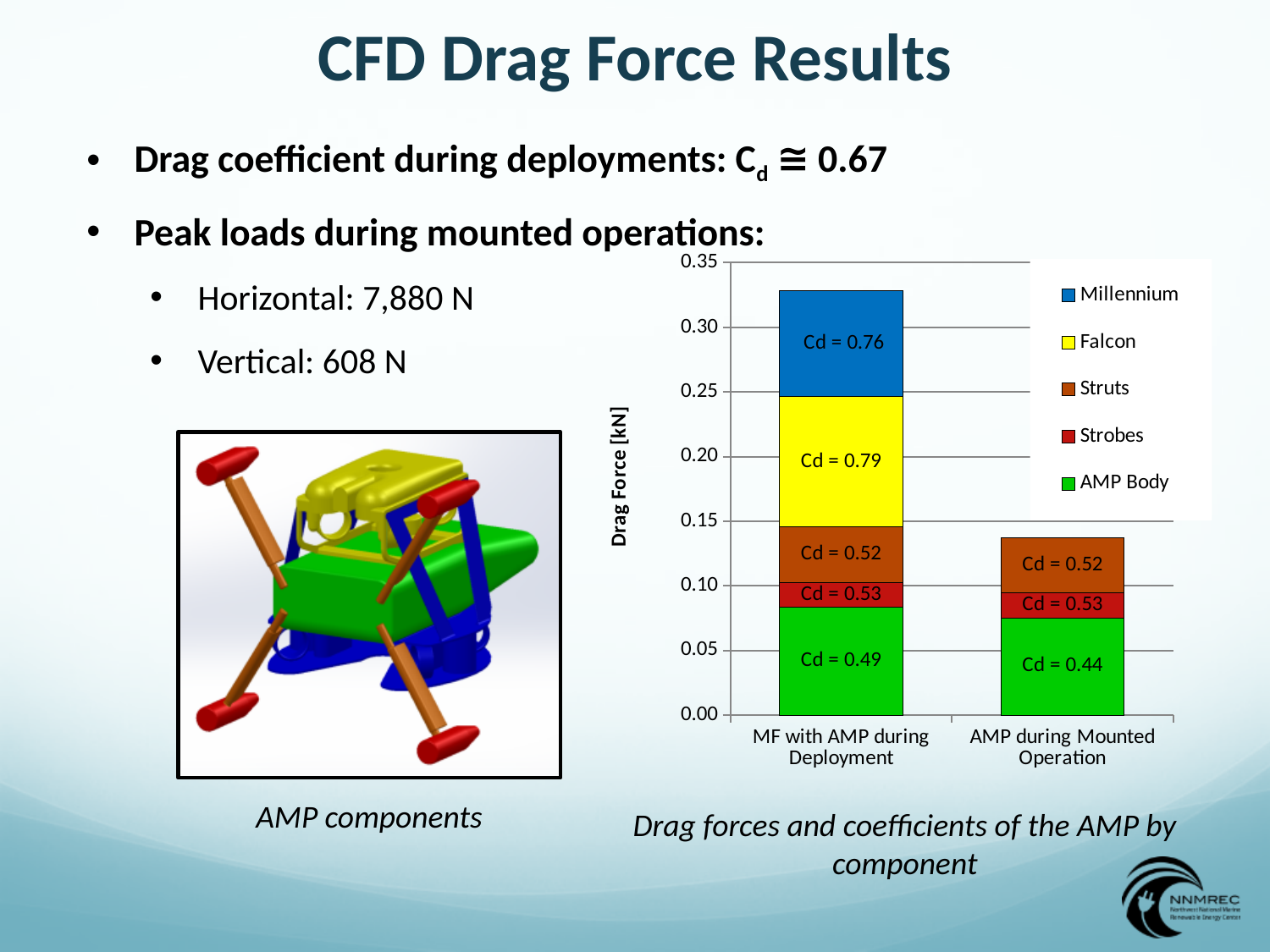
Which bar has the greater total drag force: 'MF with AMP during Deployment' or 'AMP during Mounted Operation'? MF with AMP during Deployment What Cd value is printed on the AMP Body segment of the 'AMP during Mounted Operation' bar? Cd = 0.44 What is the label on the chart's vertical axis? Drag Force [kN] How many series does the chart's legend list? 5 What Cd value is printed on the Struts segment of the 'AMP during Mounted Operation' bar? Cd = 0.52 What Cd value is printed on the Falcon segment of the 'MF with AMP during Deployment' bar? Cd = 0.79 Is the total drag force for 'AMP during Mounted Operation' greater or less than 0.20 kN? less How many categories are shown on the x axis of the chart? 2 What Cd value is printed on the Millennium segment of the 'MF with AMP during Deployment' bar? Cd = 0.76 What kind of chart is shown on the slide? bar chart Is the total drag force for 'MF with AMP during Deployment' greater or less than 0.30 kN? greater What Cd value is printed on the AMP Body segment of the 'MF with AMP during Deployment' bar? Cd = 0.49